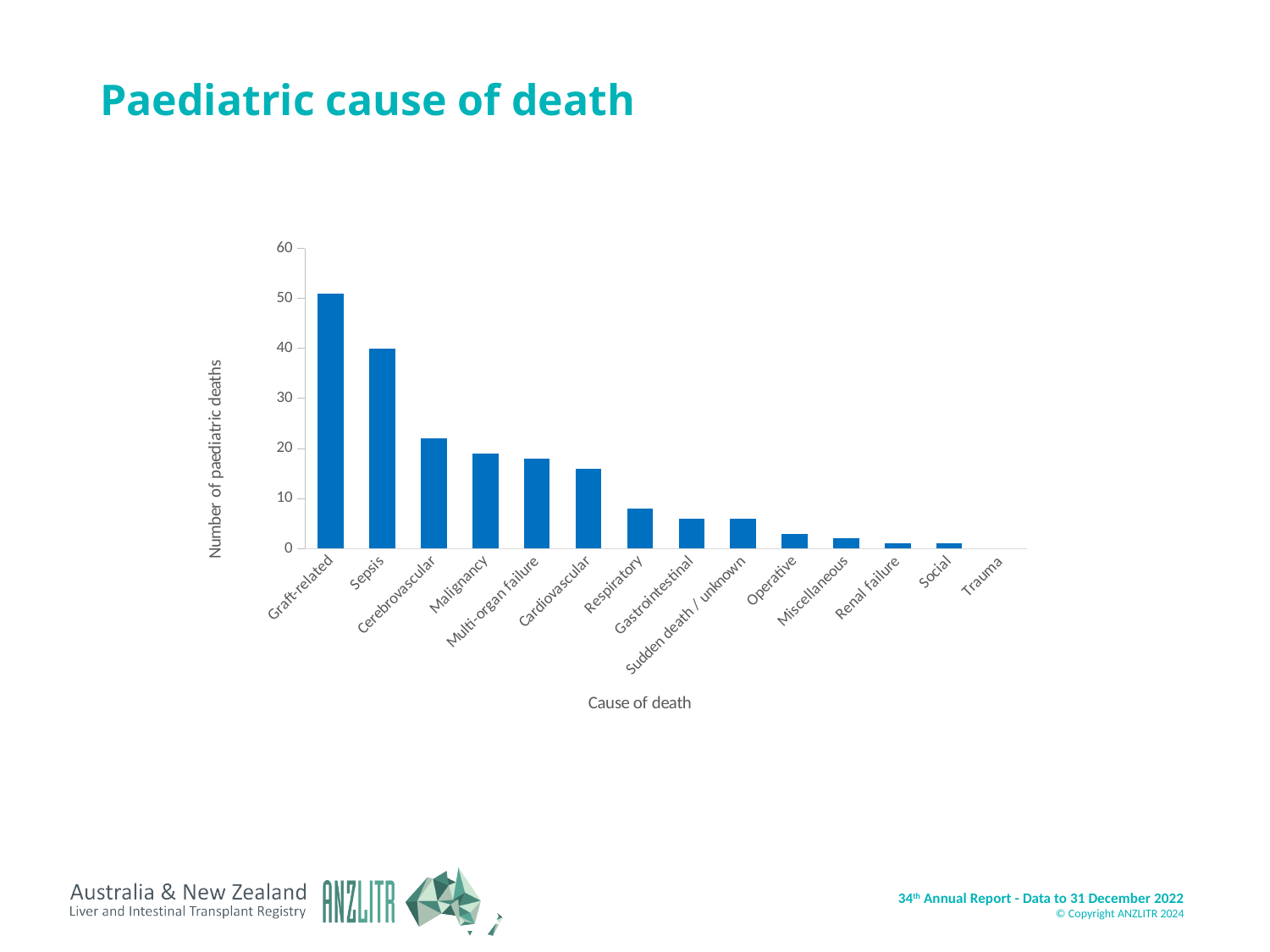
What is the label on the vertical axis? Number of paediatric deaths Which has more paediatric deaths, Sepsis or Cerebrovascular? Sepsis What kind of chart is shown on the slide? Bar chart Is the value for Cardiovascular greater or less than 10? greater Do the values rise or fall moving from left to right along the x axis? Fall Which has more paediatric deaths, Operative or Respiratory? Respiratory How many causes of death are shown on the x axis? 14 Which cause of death has the highest number of paediatric deaths? Graft-related Is the value for Respiratory greater or less than 10? less Which cause of death has the lowest number of paediatric deaths? Trauma Is the value for Cerebrovascular greater or less than 30? less